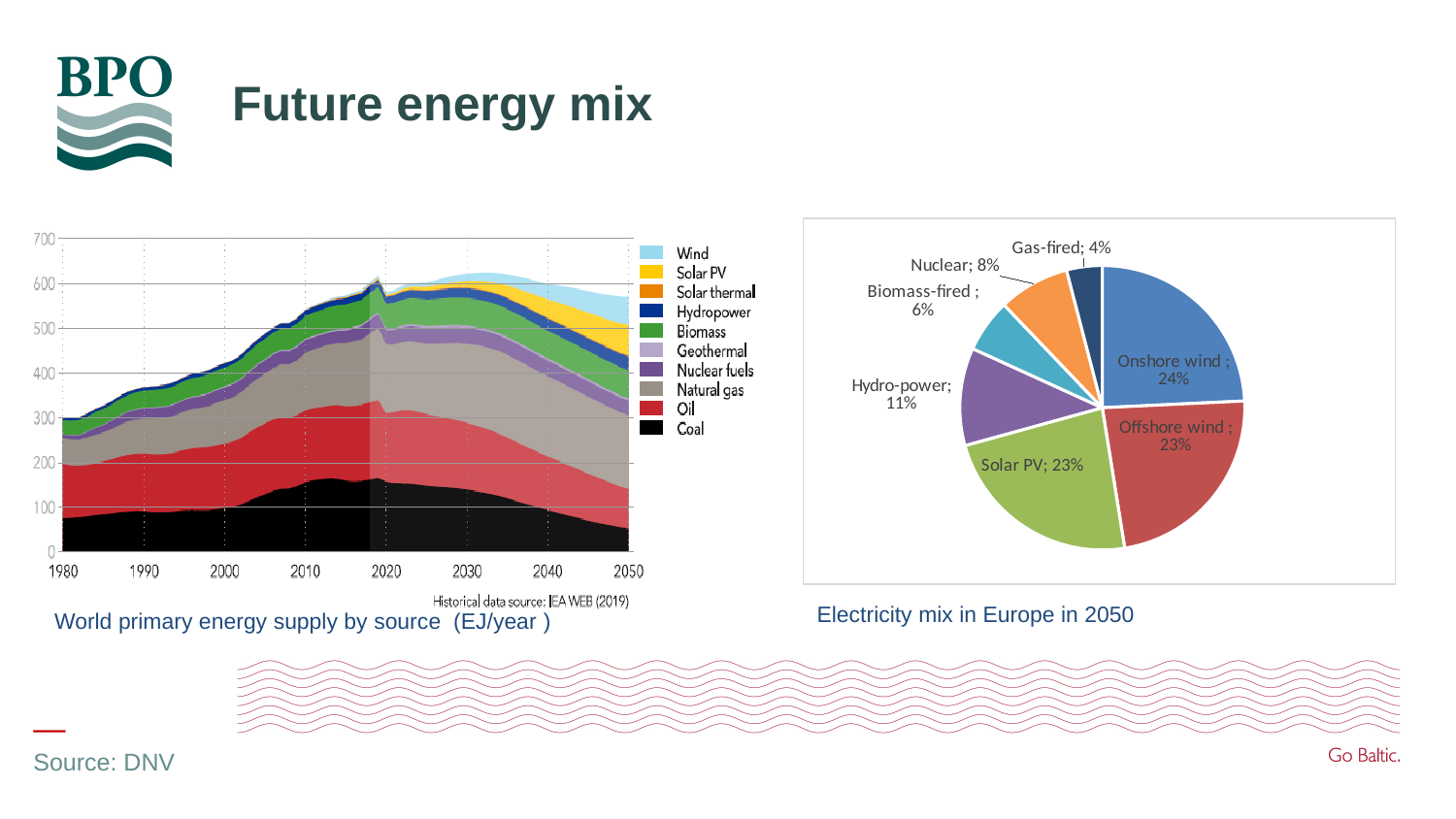
How many sources does the legend of the 'World primary energy supply by source' chart list? 10 In the 'Electricity mix in Europe in 2050' pie chart, what share is Hydro-power? 11% In the 'Electricity mix in Europe in 2050' pie chart, which is larger: Hydro-power or Biomass-fired? Hydro-power What kind of chart is 'Electricity mix in Europe in 2050'? Pie chart In the 'World primary energy supply by source' chart, does the Coal area rise or fall between 2020 and 2050? Fall In the 'World primary energy supply by source' chart, is the total supply in 1980 greater or less than 400 EJ/year? less What kind of chart is 'World primary energy supply by source'? Stacked area chart In the 'Electricity mix in Europe in 2050' pie chart, which source has the smallest share? Gas-fired In the 'Electricity mix in Europe in 2050' pie chart, which source has the largest share? Onshore wind In the 'Electricity mix in Europe in 2050' pie chart, what share is Onshore wind? 24% In the 'Electricity mix in Europe in 2050' pie chart, what is the difference in percentage points between Nuclear and Gas-fired? 4 How many slices does the 'Electricity mix in Europe in 2050' pie chart have? 7